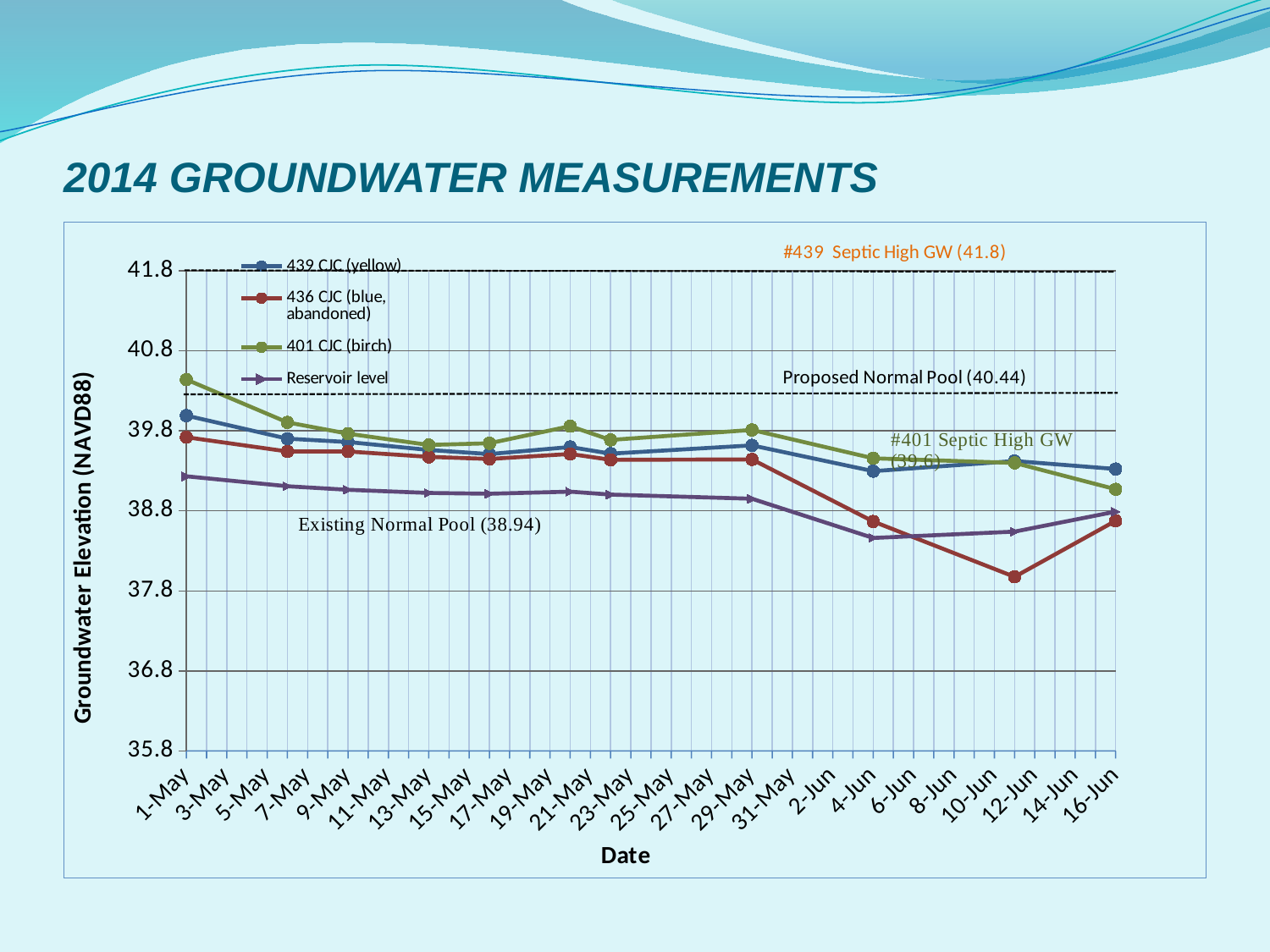
What value is given for the Existing Normal Pool? 38.94 How many series does the legend list? 4 Is the value for 401 CJC (birch) on 1-May greater or less than 39.8? greater What is the label of the y axis? Groundwater Elevation (NAVD88) What is the title of the slide's chart? 2014 GROUNDWATER MEASUREMENTS What value is given for #401 Septic High GW? 39.6 What value is given for the Proposed Normal Pool reference line? 40.44 Is the value for 436 CJC (blue, abandoned) on 10-Jun greater or less than 38.8? less What value is given for #439 Septic High GW? 41.8 What kind of chart is shown on the slide? line chart Which series has the lowest value on 10-Jun? 436 CJC (blue, abandoned) What is the difference between the Proposed Normal Pool (40.44) and the Existing Normal Pool (38.94)? 1.50